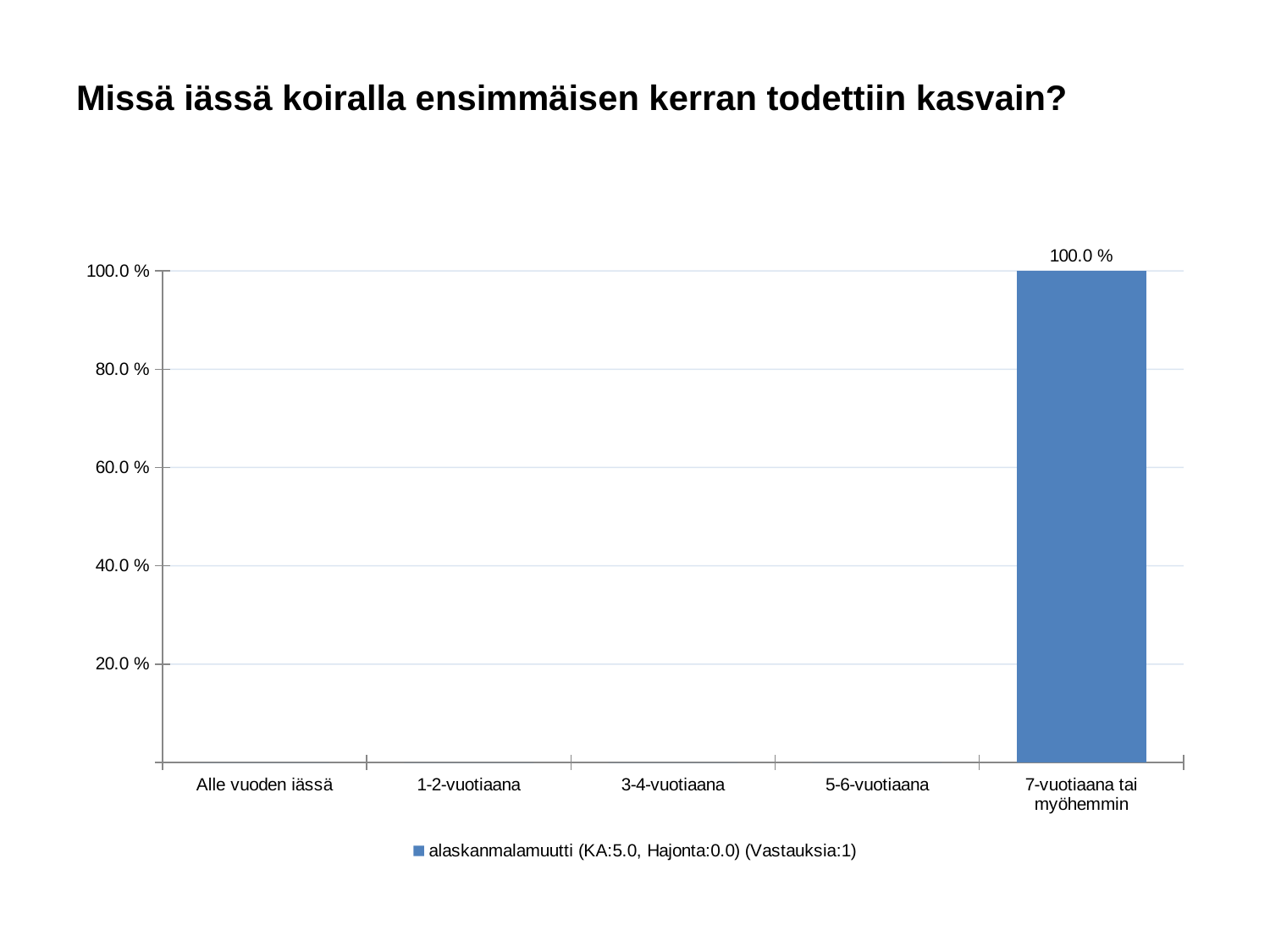
What is the value for '7-vuotiaana tai myöhemmin'? 100.0 % Which category is the only one with a visible bar? 7-vuotiaana tai myöhemmin What kind of chart is shown on the slide? bar chart What is the legend entry for the series? alaskanmalamuutti (KA:5.0, Hajonta:0.0) (Vastauksia:1) How many series does the legend list? 1 Is the value for '7-vuotiaana tai myöhemmin' greater or less than 80.0 %? greater Which category has the highest value? 7-vuotiaana tai myöhemmin What is the title of the slide? Missä iässä koiralla ensimmäisen kerran todettiin kasvain? How many categories are shown on the x axis? 5 What is the label of the first category on the x axis? Alle vuoden iässä